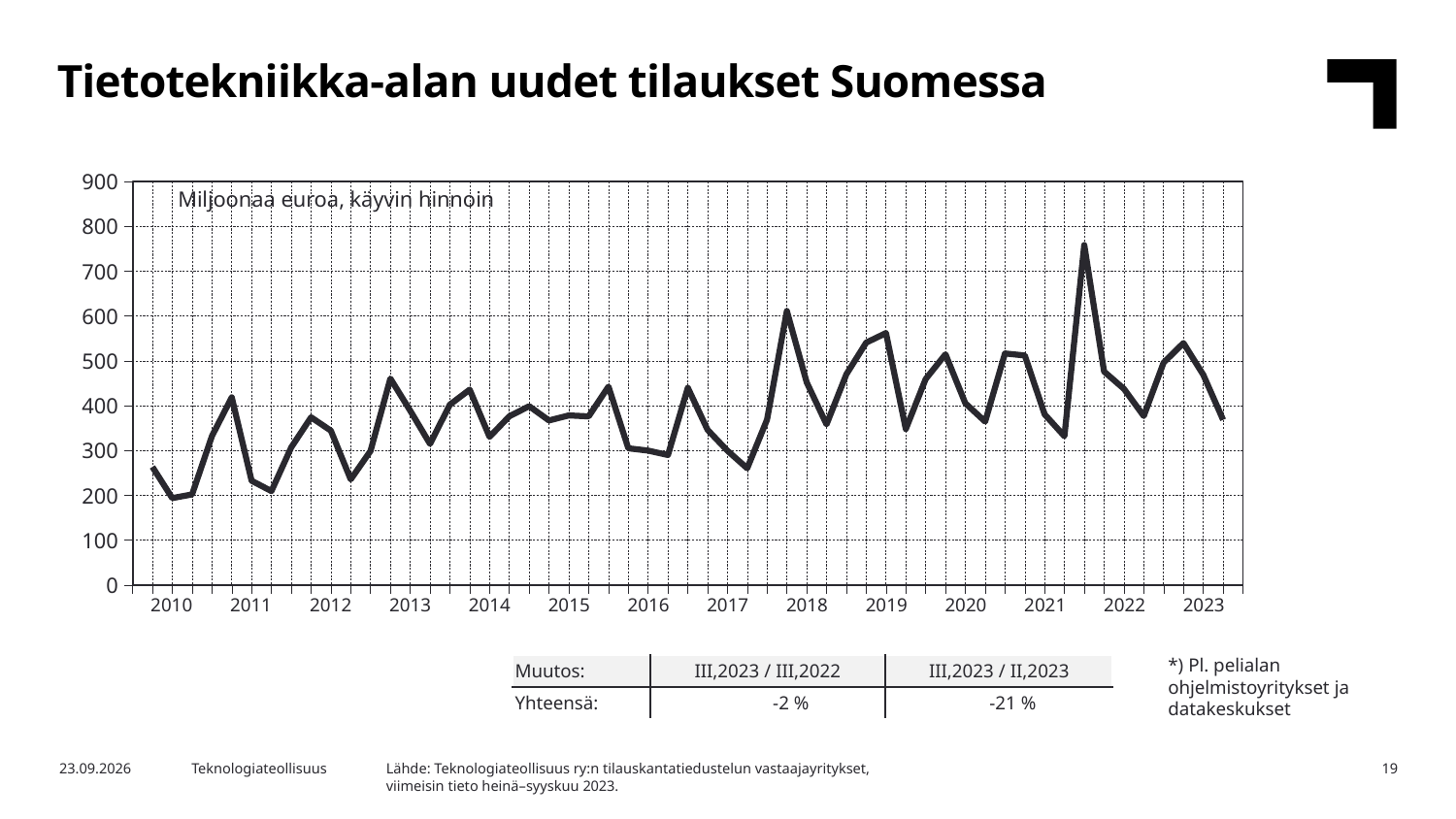
What kind of chart is shown on the slide? line chart Which is higher: the peak of the line in 2021 or the peak in 2018? 2021 What is the title of the slide's chart? Tietotekniikka-alan uudet tilaukset Suomessa Is the highest peak of the line in 2021 greater or less than 700? greater Does the line rise or fall from its 2021 peak to the end of 2023? fall Is the last plotted value in 2023 greater or less than 400? less How many data series (lines) are plotted in the chart? 1 In which year does the line reach its highest peak? 2021 Is the lowest point of the line in 2010 greater or less than 300? less In which year does the line reach its lowest point? 2010 How many years are labelled on the x axis of the chart? 14 What unit is stated in the label inside the chart area? Miljoonaa euroa, käyvin hinnoin